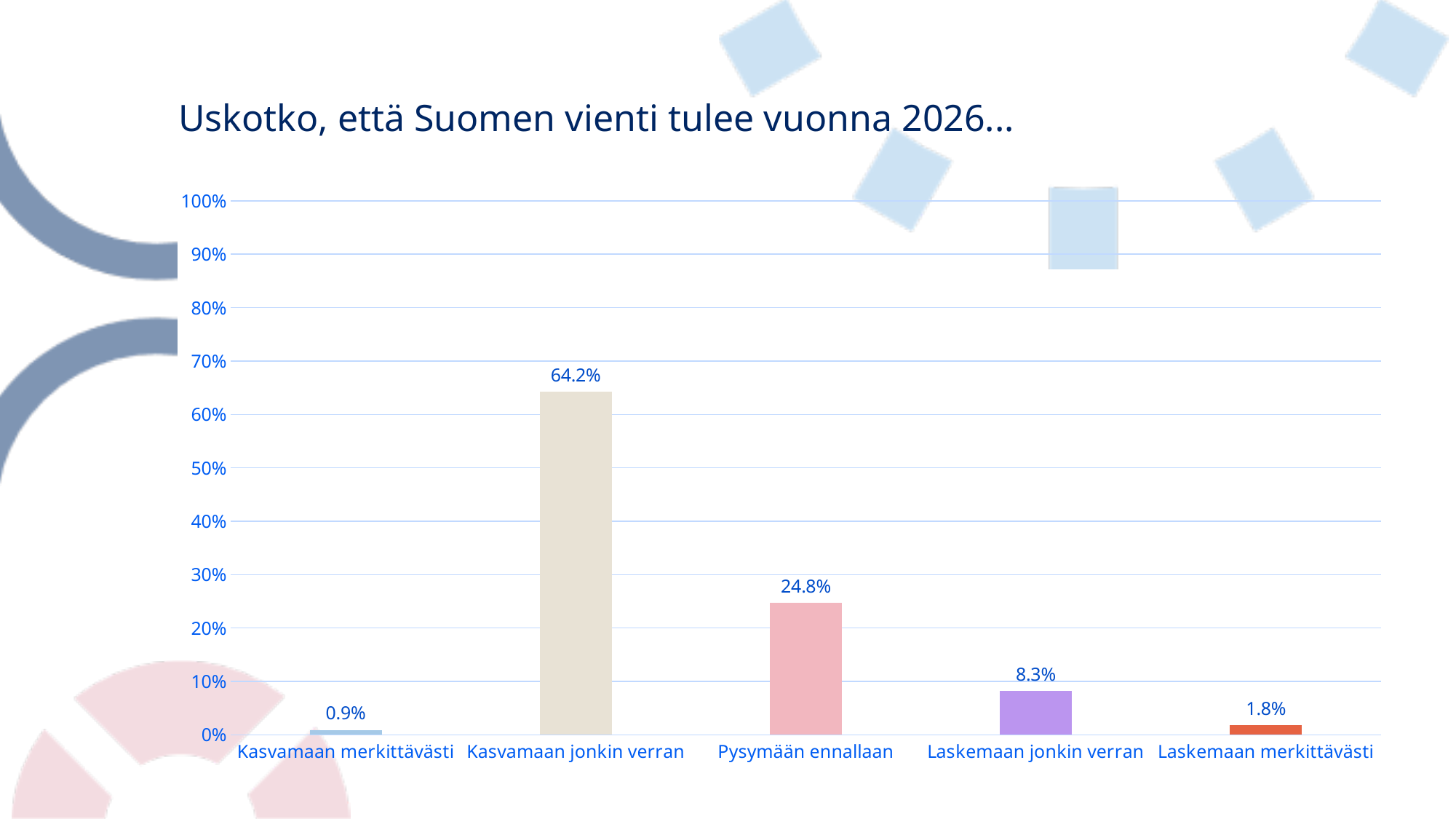
Which category has the lowest value? Kasvamaan merkittävästi Is the value for "Pysymään ennallaan" greater or less than 20%? greater What is the value for "Laskemaan merkittävästi"? 1.8% What is the value for "Laskemaan jonkin verran"? 8.3% Which is larger, the value for "Laskemaan jonkin verran" or "Laskemaan merkittävästi"? Laskemaan jonkin verran What is the difference between the values for "Kasvamaan jonkin verran" and "Pysymään ennallaan"? 39.4% What kind of chart is shown on the slide? Bar chart What is the value for "Kasvamaan jonkin verran"? 64.2% What is the value for "Kasvamaan merkittävästi"? 0.9% How many categories are shown on the chart? 5 Which category has the highest value? Kasvamaan jonkin verran What is the value for "Pysymään ennallaan"? 24.8%